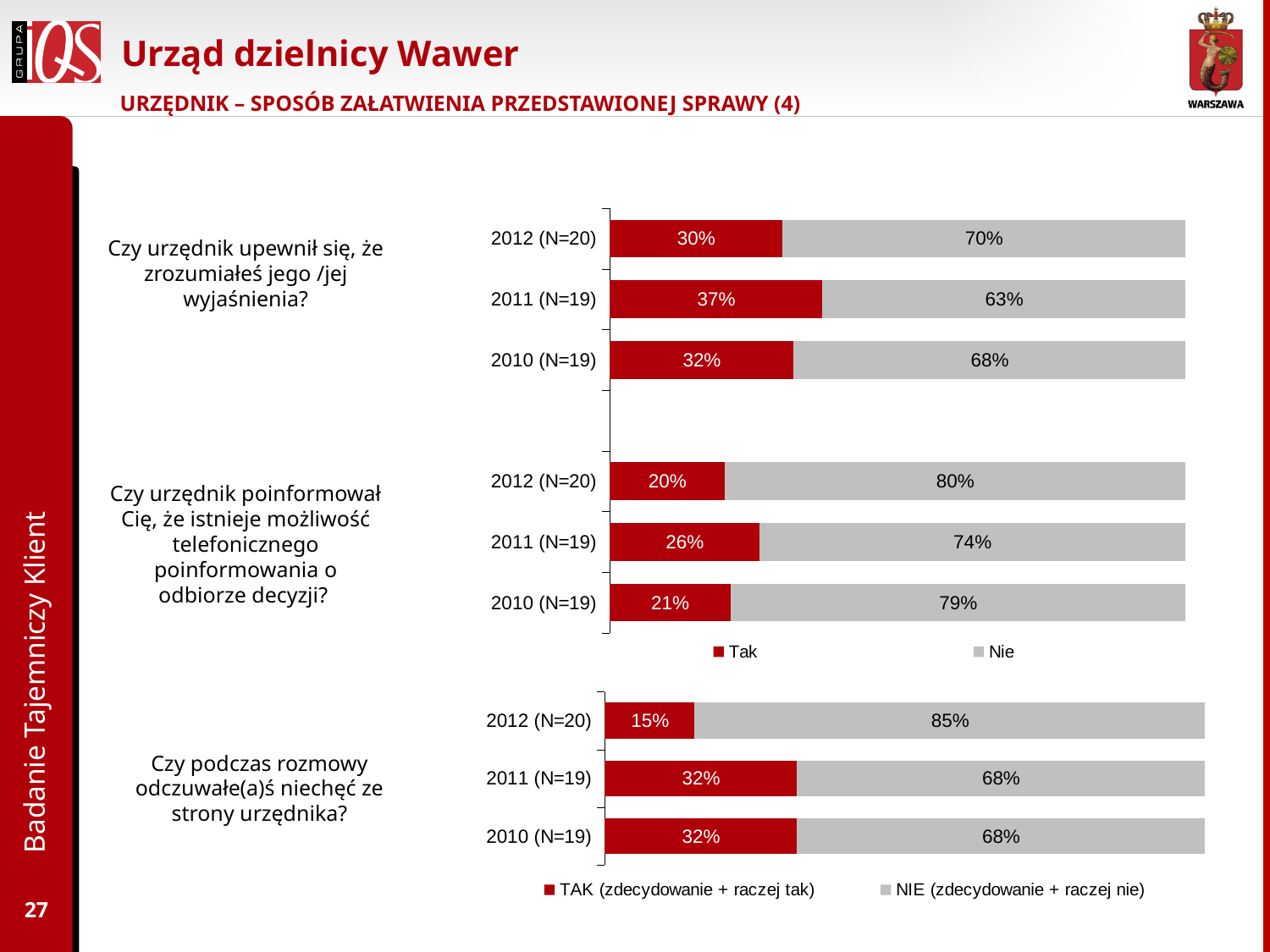
In the upper chart, what is the 'Tak' value for 2012 (N=20) for the question 'Czy urzędnik upewnił się, że zrozumiałeś jego /jej wyjaśnienia?'? 30% What are the two legend entries of the upper chart? Tak, Nie How many series does the legend of the lower chart list? 2 How many bars does the lower chart contain? 3 In the upper chart, what is the 'Nie' value for 2011 (N=19) for the question 'Czy urzędnik poinformował Cię, że istnieje możliwość telefonicznego poinformowania o odbiorze decyzji?'? 74% What type of chart is the upper chart? Stacked bar chart In the upper chart, for the question 'Czy urzędnik upewnił się, że zrozumiałeś jego /jej wyjaśnienia?', which year has the highest 'Tak' value? 2011 (N=19) In the lower chart, what is the 'TAK' value for 2012 (N=20)? 15% In the lower chart, what is the difference between the 'NIE' value for 2012 (N=20) and the 'NIE' value for 2011 (N=19)? 17% In the upper chart, for the question 'Czy urzędnik poinformował Cię, że istnieje możliwość telefonicznego poinformowania o odbiorze decyzji?', which year has the lowest 'Tak' value? 2012 (N=20) In the lower chart, what is the total of the 2010 (N=19) bar? 100% In the upper chart, is the 'Tak' value for 2011 (N=19) larger for 'Czy urzędnik upewnił się...' or for 'Czy urzędnik poinformował Cię...'? Czy urzędnik upewnił się...